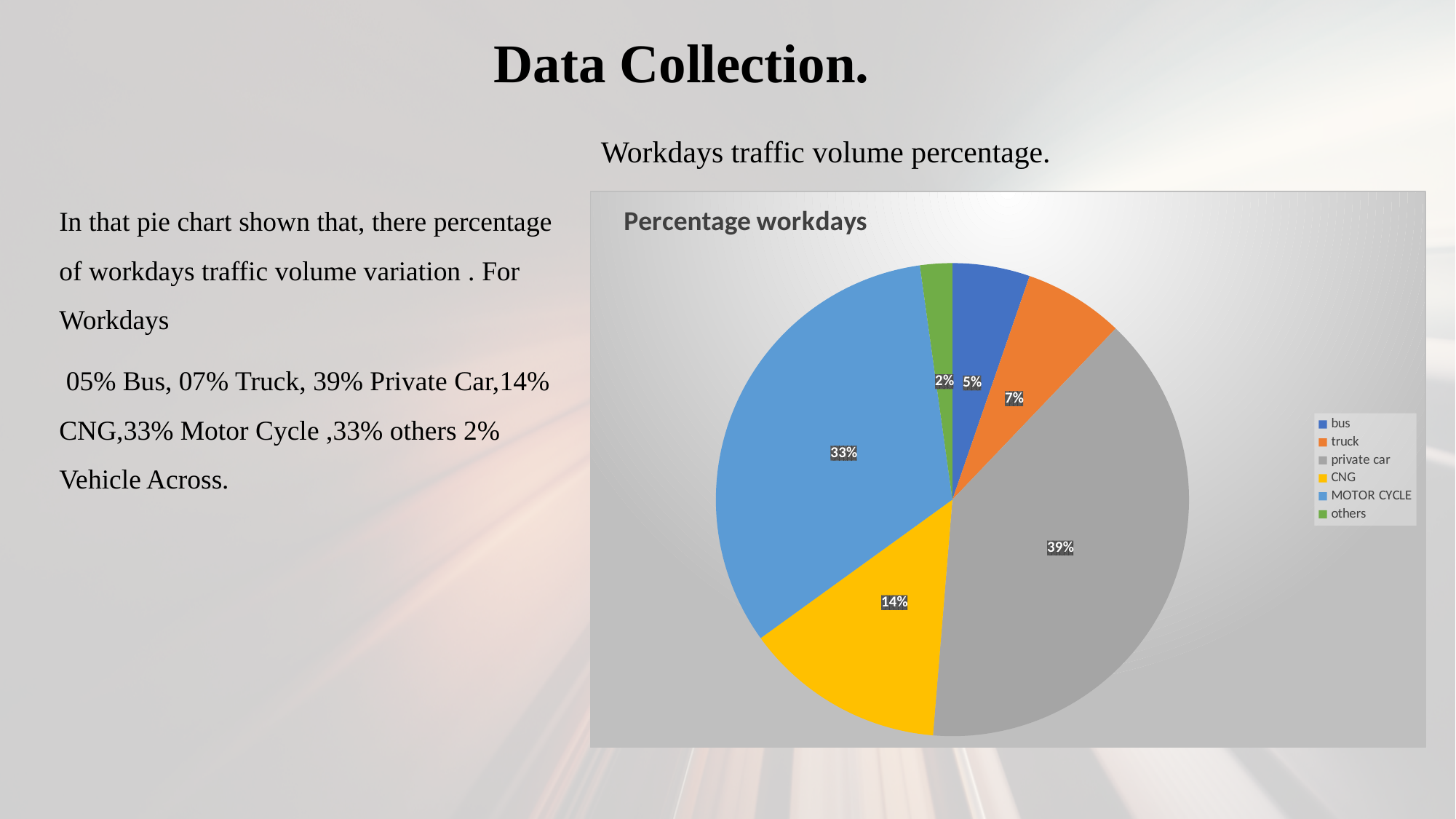
What is the value shown for CNG? 14% Which category has the smallest slice of the pie? others What percentage of the pie does private car account for? 39% Which category has the largest slice of the pie? private car What is the value shown for MOTOR CYCLE? 33% What type of chart is shown on the slide? pie chart What is the chart's title? Percentage workdays How many categories does the legend list? 6 What is the difference between the private car and MOTOR CYCLE percentages? 6% What is the value shown for bus? 5% What is the value shown for truck? 7% Which is larger, the CNG slice or the truck slice? CNG